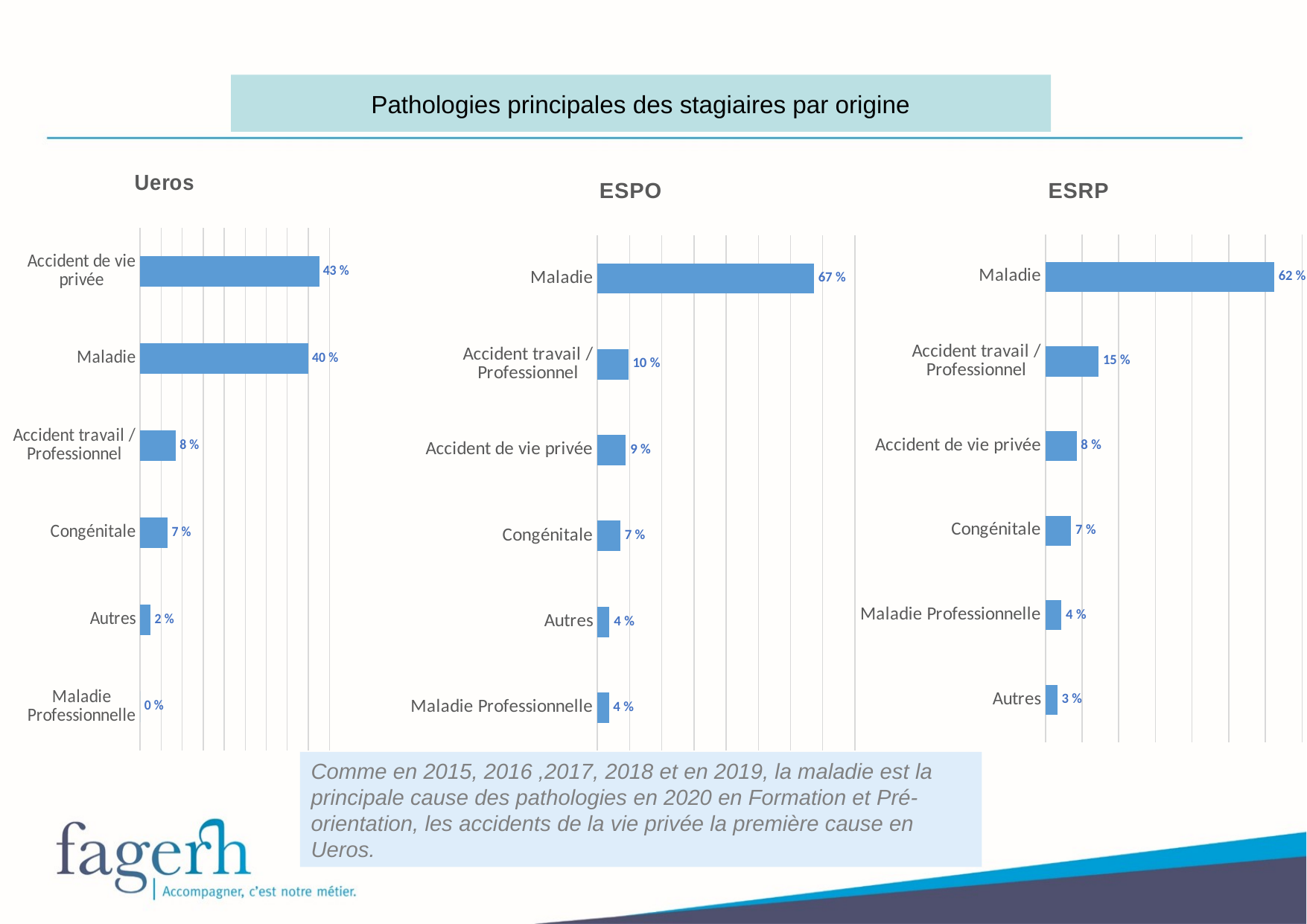
How many categories does the ESPO chart show? 6 In the Ueros chart, what is the value for Accident de vie privée? 43 % In the Ueros chart, what is the difference between Accident de vie privée and Maladie? 3 % In the ESPO chart, what is the difference between Maladie and Accident travail / Professionnel? 57 % In the ESRP chart, which category has the lowest value? Autres In the Ueros chart, which category has the highest value? Accident de vie privée Which is larger: Maladie in the ESPO chart or Maladie in the ESRP chart? ESPO In the ESPO chart, what is the value for Maladie? 67 % What is the title of the slide's chart section? Pathologies principales des stagiaires par origine In the ESRP chart, what is the value for Accident travail / Professionnel? 15 % In the Ueros chart, what is the value for Maladie Professionnelle? 0 % What kind of chart is the ESRP chart? Bar chart